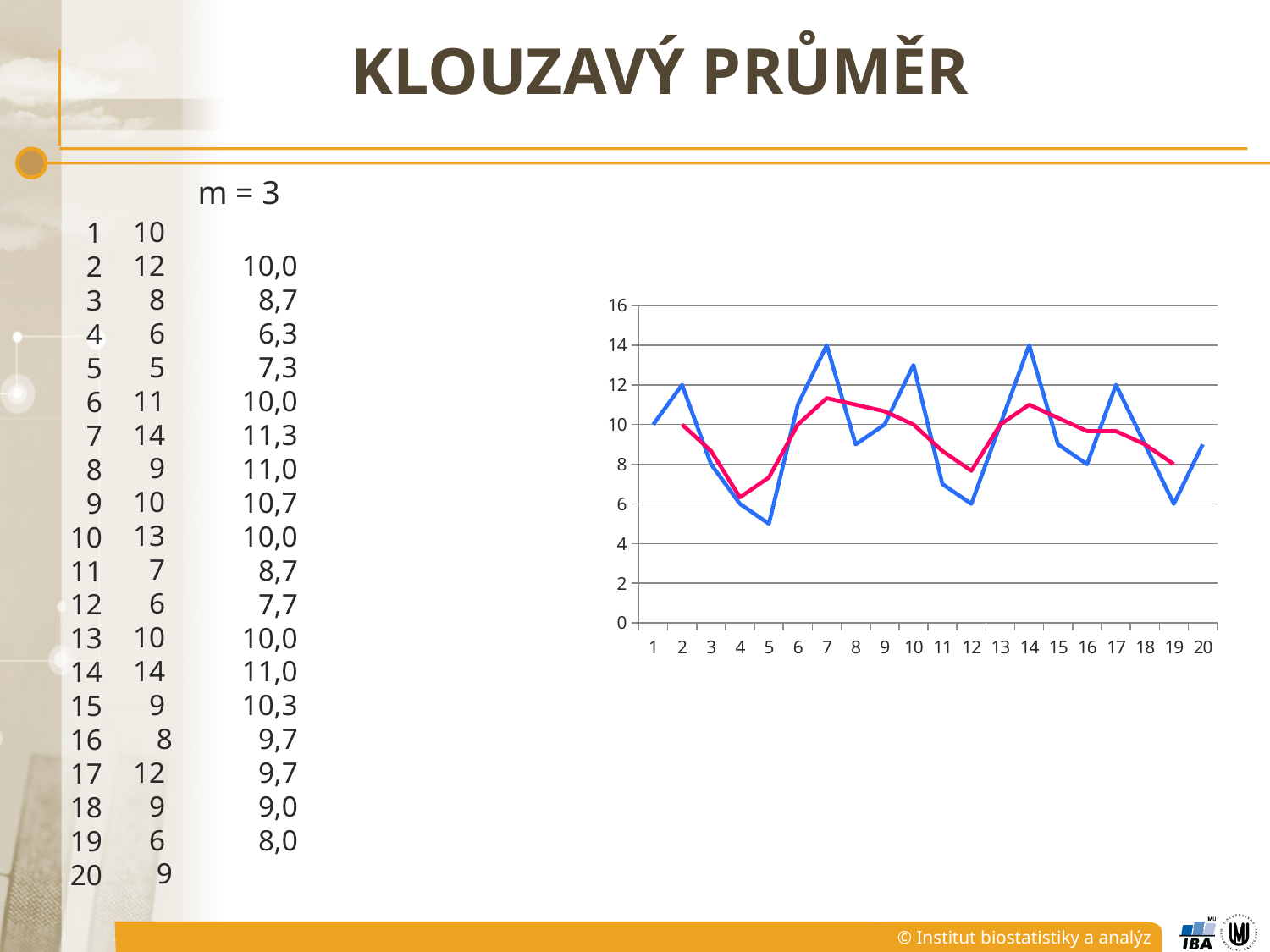
What is the difference between the blue line's value at x = 14 and at x = 12? 8 What is the value of the blue line at x = 12? 6 Is the value of the red line at x = 7 greater or less than 10? greater What is the value of the blue line at x = 7? 14 How many points are labelled along the x axis of the chart? 20 Which is larger, the blue line's value at x = 7 or at x = 8? x = 7 At which x value does the red line reach its lowest point? 4 How many lines are plotted on the chart? 2 At which x value does the blue line reach its lowest point? 5 What is the title of the slide containing the chart? KLOUZAVÝ PRŮMĚR Is the value of the blue line at x = 5 greater or less than 6? less What kind of chart is shown on the slide? line chart